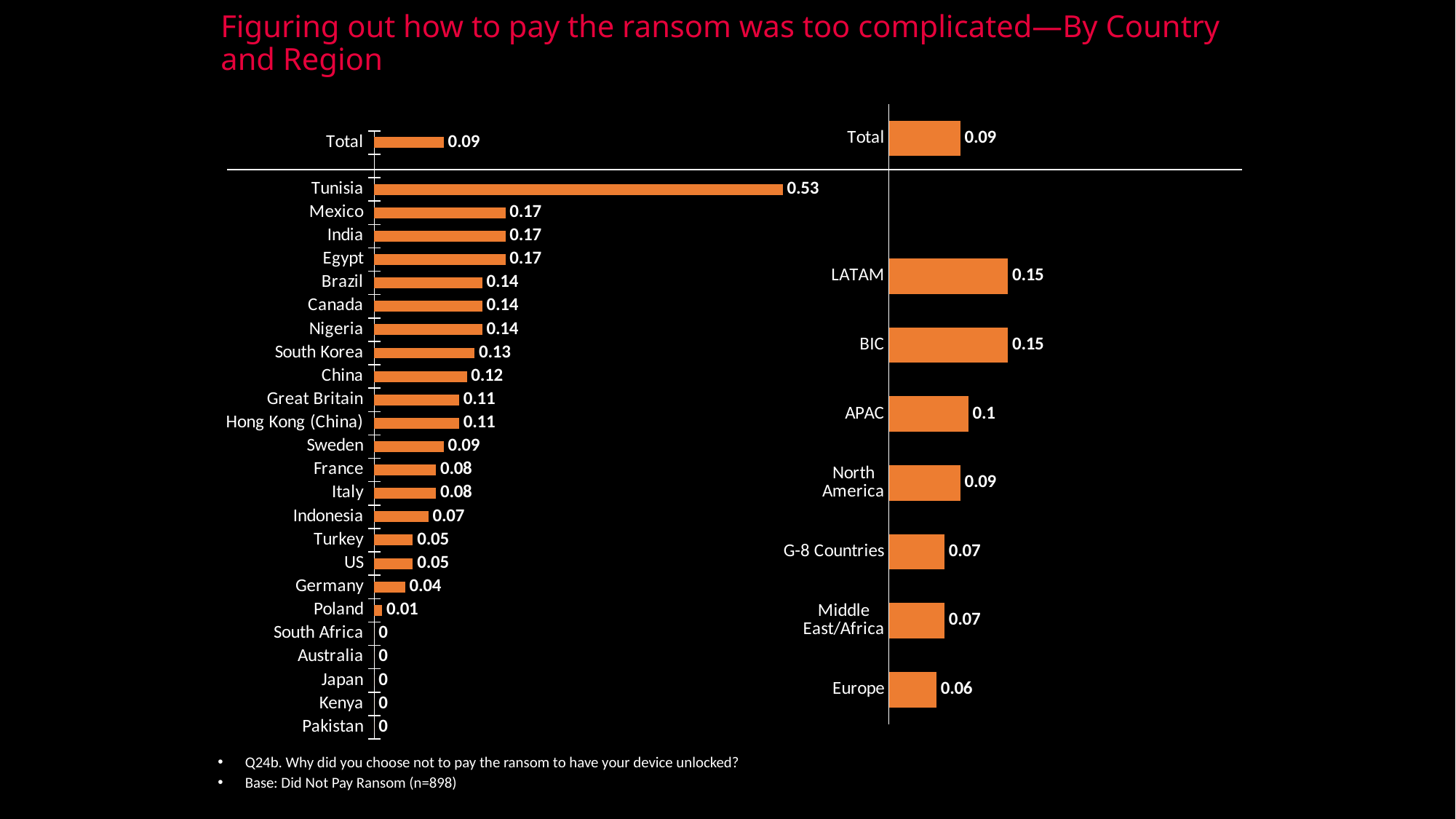
In the right chart (by region), which region has the lowest value? Europe In the left chart (by country), how many countries have a value of 0? 5 In the left chart (by country), what is the value for Poland? 0.01 In the right chart (by region), how many regions are shown below the Total bar? 7 In the right chart (by region), what is the value for APAC? 0.1 In the left chart (by country), what is the value for Tunisia? 0.53 In the left chart (by country), which is larger, the value for China or the value for Germany? China In the left chart (by country), what is the value for South Korea? 0.13 What kind of chart is the right chart (by region)? Bar chart In the left chart (by country), what is the difference between the values for Tunisia and Mexico? 0.36 In the left chart (by country), which country has the highest value? Tunisia In the right chart (by region), what is the difference between the values for LATAM and Europe? 0.09